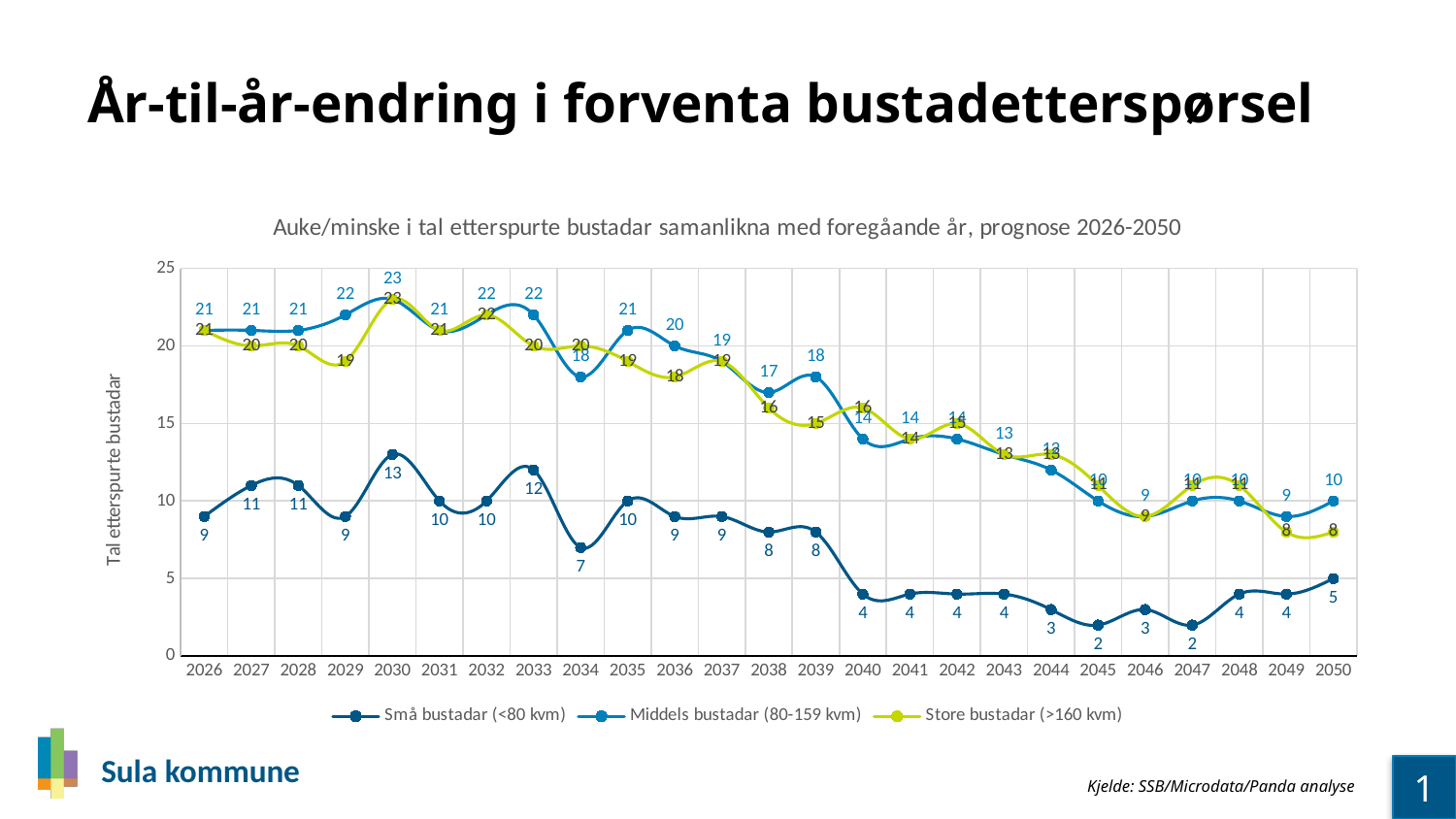
What is the value for Små bustadar (<80 kvm) in 2050? 5 In which year does Små bustadar (<80 kvm) reach its highest value? 2030 What is the difference between Middels bustadar (80-159 kvm) and Små bustadar (<80 kvm) in 2026? 12 What kind of chart is shown on the slide? line chart Which is larger in 2039: Middels bustadar (80-159 kvm) or Store bustadar (>160 kvm)? Middels bustadar (80-159 kvm) Does the Små bustadar (<80 kvm) series overall rise or fall from 2026 to 2050? fall What is the label on the vertical axis of the chart? Tal etterspurte bustadar What is the value for Middels bustadar (80-159 kvm) in 2030? 23 In which year does Middels bustadar (80-159 kvm) reach its highest value? 2030 How many years are plotted along the x axis? 25 How many series does the legend list? 3 What is the value for Små bustadar (<80 kvm) in 2034? 7